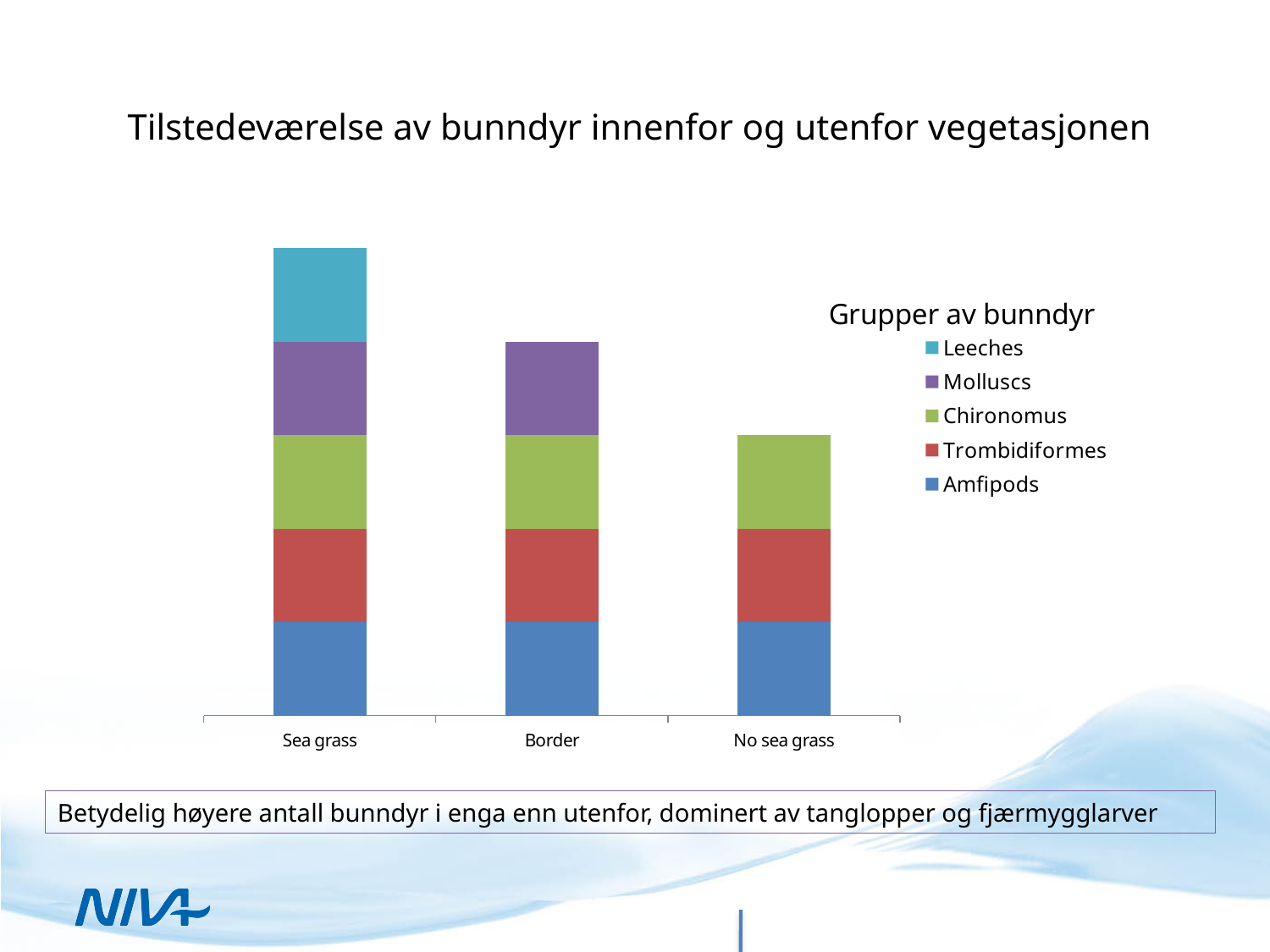
Do the total bar heights rise or fall from Sea grass to No sea grass along the x axis? Fall Which stacked bar is taller, Sea grass or No sea grass? Sea grass What kind of chart is shown on the slide? Stacked bar chart How many categories are shown on the x axis of the chart? 3 Which category is the only one with a Leeches segment in its bar? Sea grass What is the title of the chart's legend? Grupper av bunndyr Which series is shown at the bottom of each stacked bar? Amfipods Which stacked bar is taller, Border or No sea grass? Border Which category has the shortest stacked bar? No sea grass Which category has the tallest stacked bar? Sea grass Which category has no Molluscs segment in its bar? No sea grass How many series does the chart's legend list? 5